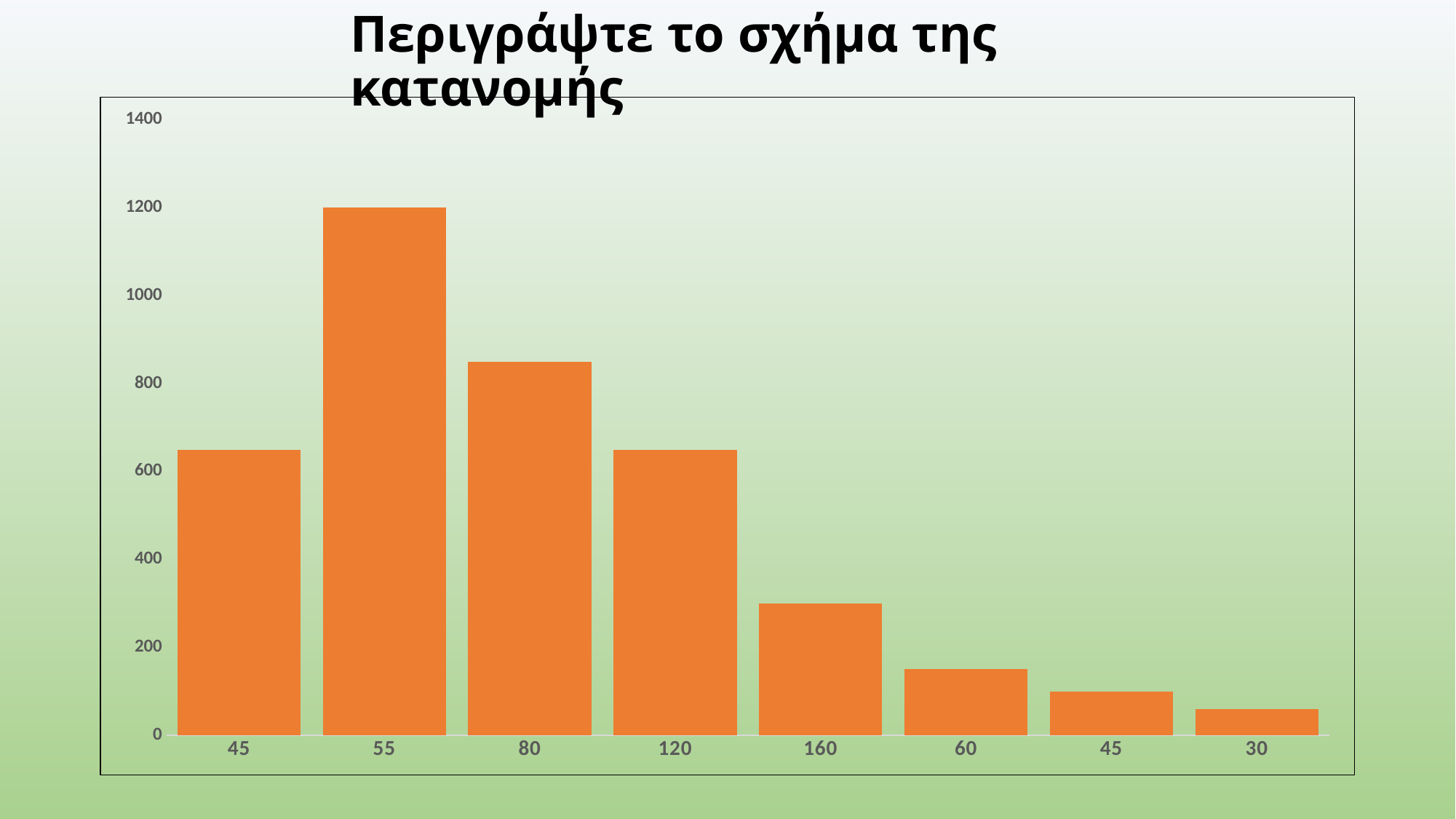
Which is larger, the value for 80 or the value for 120? 80 What kind of chart is shown on the slide? bar chart Which category has the highest bar? 55 How many bars does the chart have? 8 Which category has the lowest bar? 30 Is the value for 80 greater or less than 800? greater Is the value for 60 greater or less than 200? less Is the value for 160 greater or less than 200? greater What is the title of the slide above the chart? Περιγράψτε το σχήμα της κατανομής Do the values rise or fall from the category 80 to the category 30 along the x axis? fall